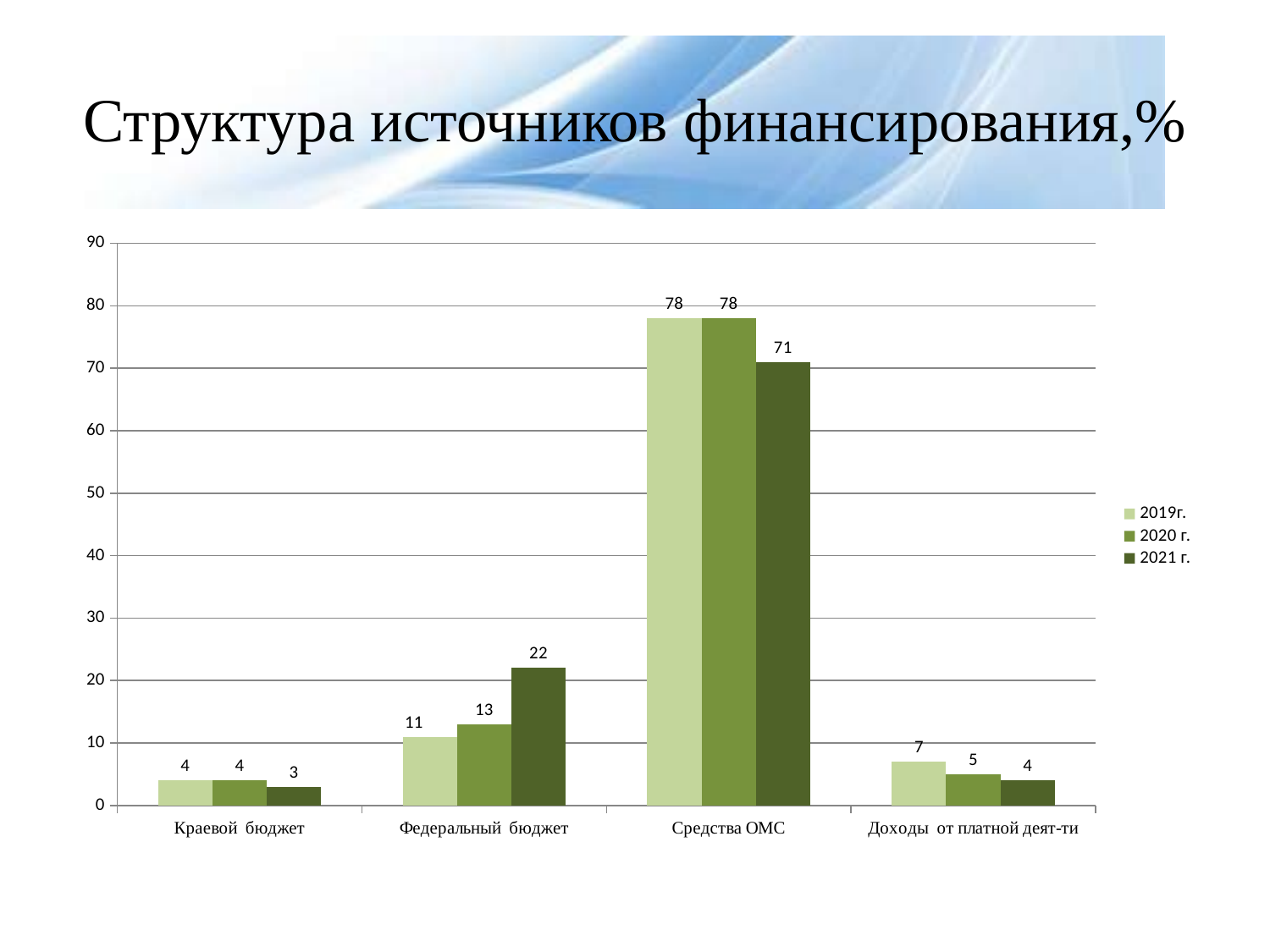
What kind of chart is shown on the slide? Bar chart What is the value for Средства ОМС in 2021 г.? 71 What is the value for Федеральный бюджет in 2020 г.? 13 What is the value for Доходы от платной деят-ти in 2019г.? 7 What is the title of the slide? Структура источников финансирования,% What is the difference between the 2021 г. and 2019г. values for Федеральный бюджет? 11 Which category has the highest value in 2019г.? Средства ОМС What is the value for Краевой бюджет in 2021 г.? 3 How many series does the legend list? 3 Which is larger for Доходы от платной деят-ти: the 2019г. value or the 2021 г. value? 2019г. How many categories are shown on the x axis? 4 Which category has the lowest value in 2021 г.? Краевой бюджет